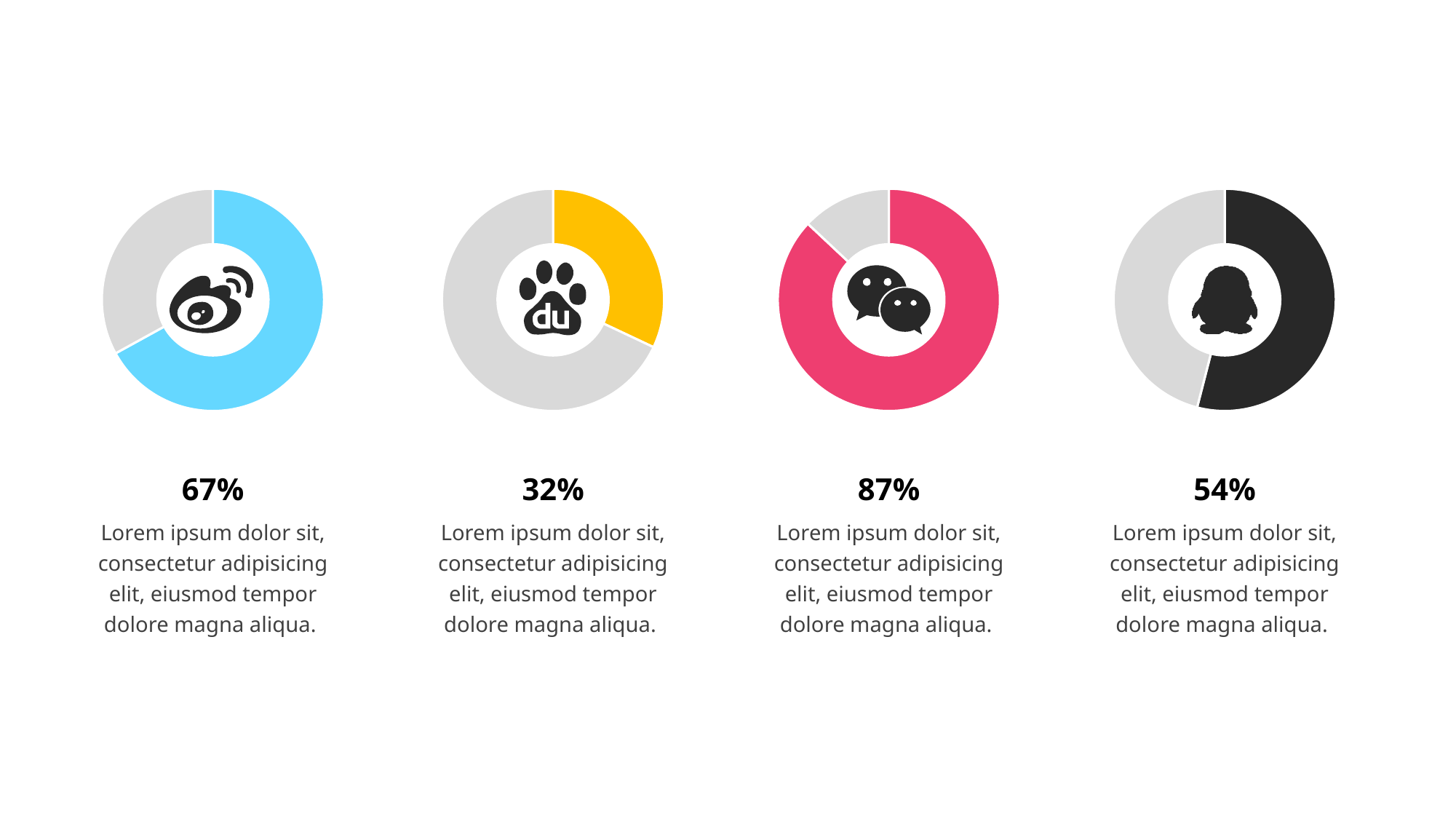
What is the difference between the percentage of the pink donut chart and the percentage of the yellow donut chart? 55% Which of the four donut charts shows the highest percentage? The third (pink) chart, 87% How many donut charts are on the slide? 4 Which of the four donut charts shows the lowest percentage? The second (yellow) chart, 32% What percentage is shown below the third donut chart from the left (the pink one)? 87% What colour is the filled portion of the third donut chart from the left? Pink What percentage is shown below the leftmost donut chart (the blue one)? 67% What is the difference between the percentages of the leftmost (blue) and rightmost (black) donut charts? 13% What kind of chart is used for each of the four figures on the slide? Donut (pie) chart What percentage is shown below the second donut chart from the left (the yellow one)? 32% What percentage is shown below the rightmost donut chart (the black one)? 54% Which is larger: the percentage of the leftmost (blue) donut chart or the rightmost (black) donut chart? The leftmost (blue) chart, 67%